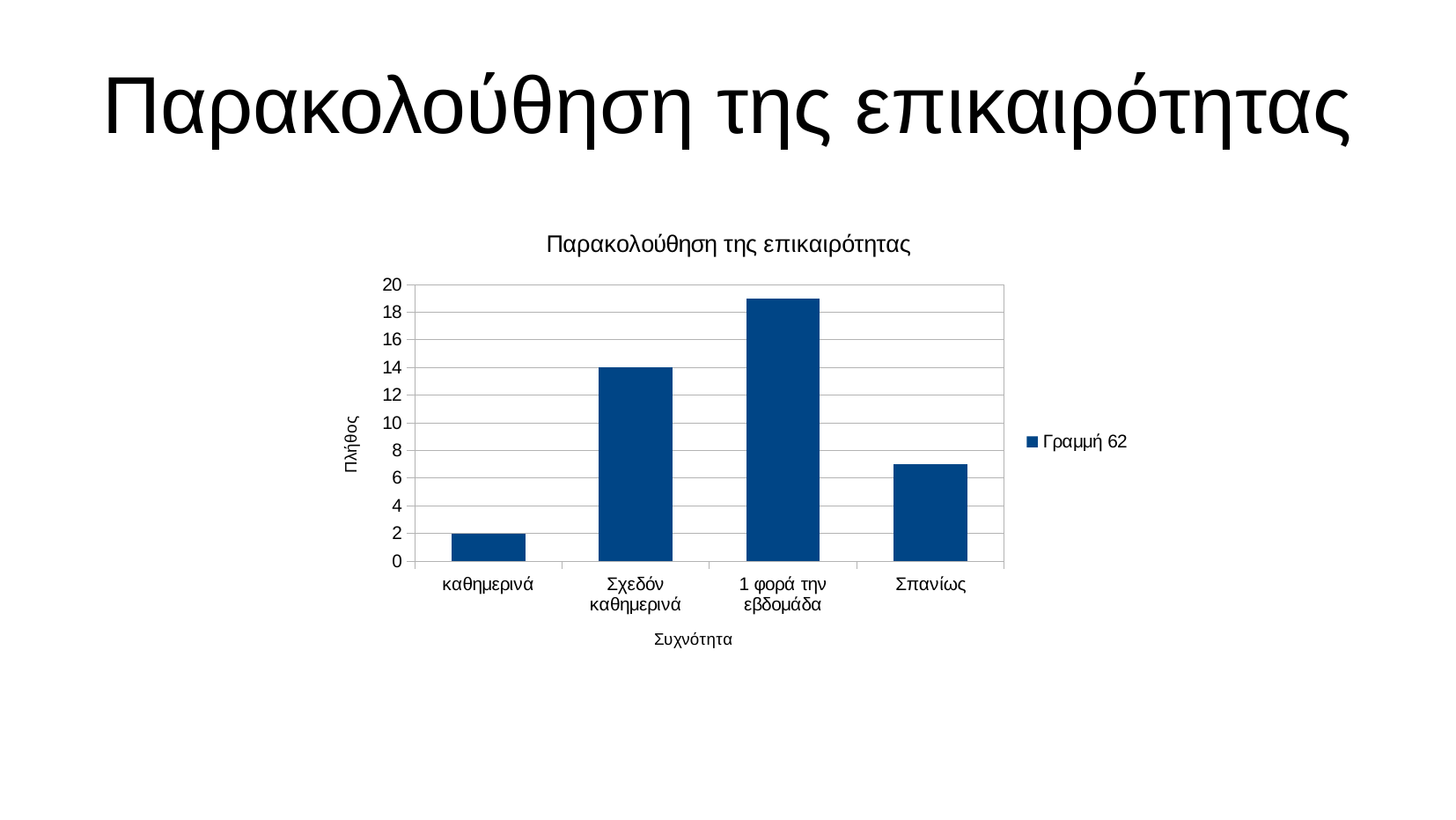
Is the value for Σπανίως greater or less than 8? less What is the value for καθημερινά? 2 How many categories are shown on the x axis? 4 Which category has the lowest value? καθημερινά What is the legend entry of the chart? Γραμμή 62 What kind of chart is shown on the slide? bar chart How many series does the legend list? 1 Which is larger, the value for Σπανίως or the value for Σχεδόν καθημερινά? Σχεδόν καθημερινά Which category has the highest value? 1 φορά την εβδομάδα Is the value for 1 φορά την εβδομάδα greater or less than 18? greater What is the value for Σχεδόν καθημερινά? 14 What is the difference between the values for Σχεδόν καθημερινά and καθημερινά? 12